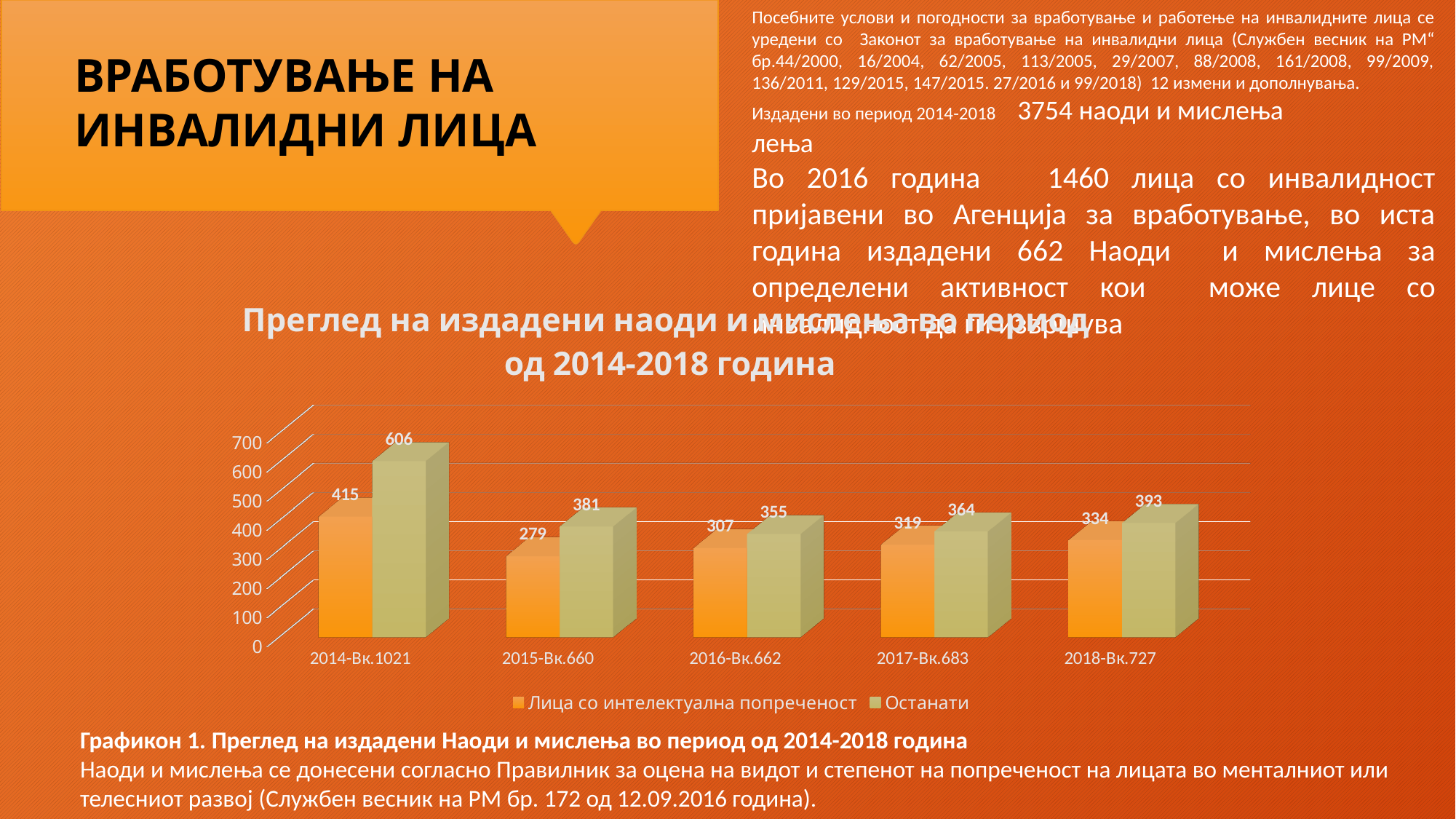
Which series is shown in orange in the chart legend? Лица со интелектуална попреченост What is the value for 'Лица со интелектуална попреченост' in 2018-Вк.727? 334 What is the value for 'Лица со интелектуална попреченост' in 2014-Вк.1021? 415 What is the difference between 'Останати' and 'Лица со интелектуална попреченост' in 2014-Вк.1021? 191 Which is larger in 2017-Вк.683: 'Лица со интелектуална попреченост' or 'Останати'? Останати What is the value for 'Останати' in 2016-Вк.662? 355 What type of chart is shown on the slide? bar chart What is the total of 'Лица со интелектуална попреченост' and 'Останати' in 2015-Вк.660? 660 Which year has the lowest value for 'Лица со интелектуална попреченост'? 2015-Вк.660 Which year has the highest value for 'Останати'? 2014-Вк.1021 How many year categories are shown on the x axis of the chart? 5 How many series does the chart legend list? 2